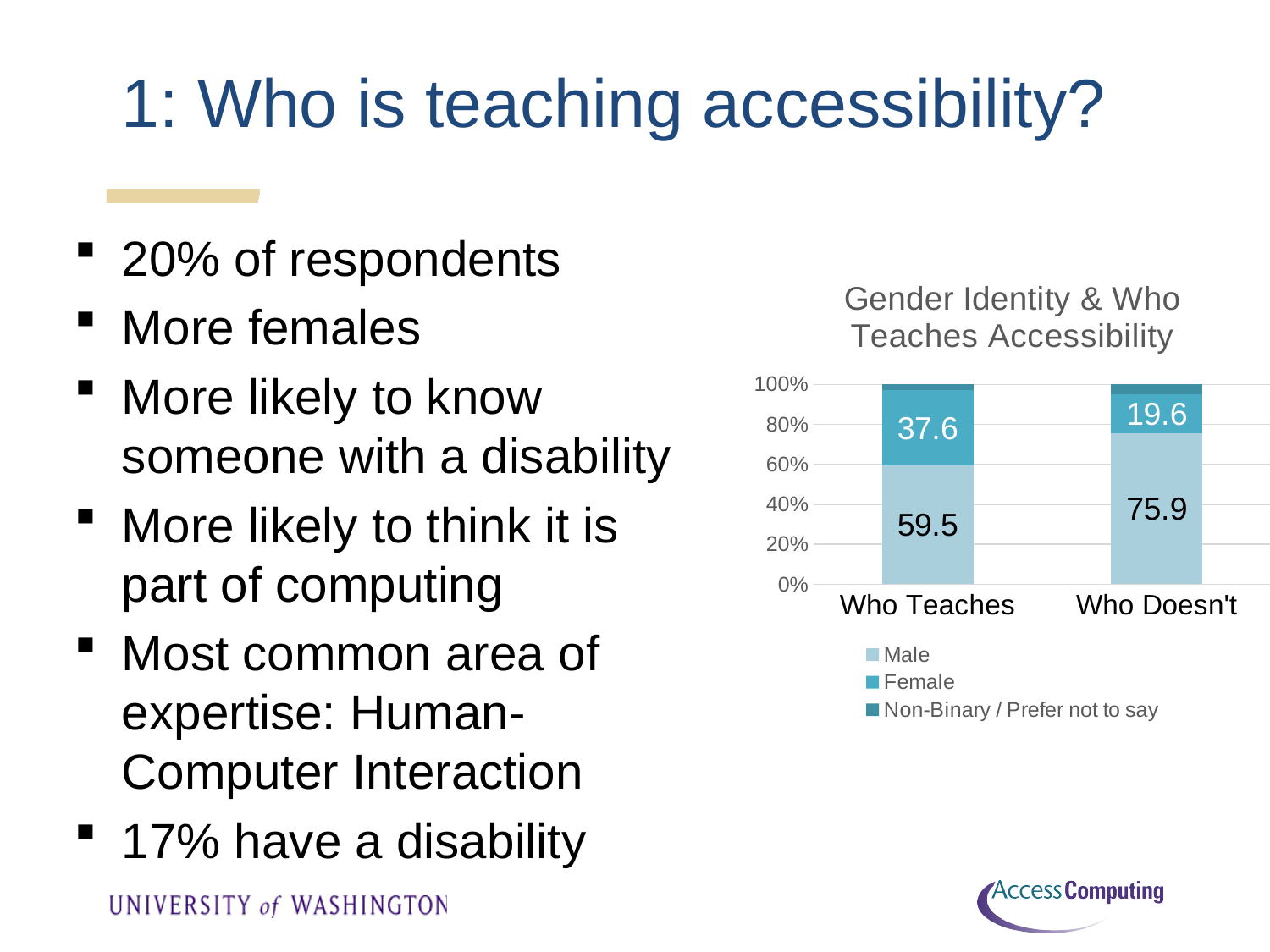
What type of chart is shown on the slide? Stacked bar chart What is the Male value for the Who Teaches bar? 59.5 Which category has the larger Male value, Who Teaches or Who Doesn't? Who Doesn't What is the difference between the Male values for Who Doesn't and Who Teaches? 16.4 How many series does the chart legend list? 3 What is the difference between the Female values for Who Teaches and Who Doesn't? 18 Which category has the larger Female value, Who Teaches or Who Doesn't? Who Teaches What is the Male value for the Who Doesn't bar? 75.9 What is the Female value for the Who Teaches bar? 37.6 How many categories are shown on the x axis of the chart? 2 Is the Non-Binary / Prefer not to say segment of the Who Teaches bar greater or less than 20%? less What is the Female value for the Who Doesn't bar? 19.6